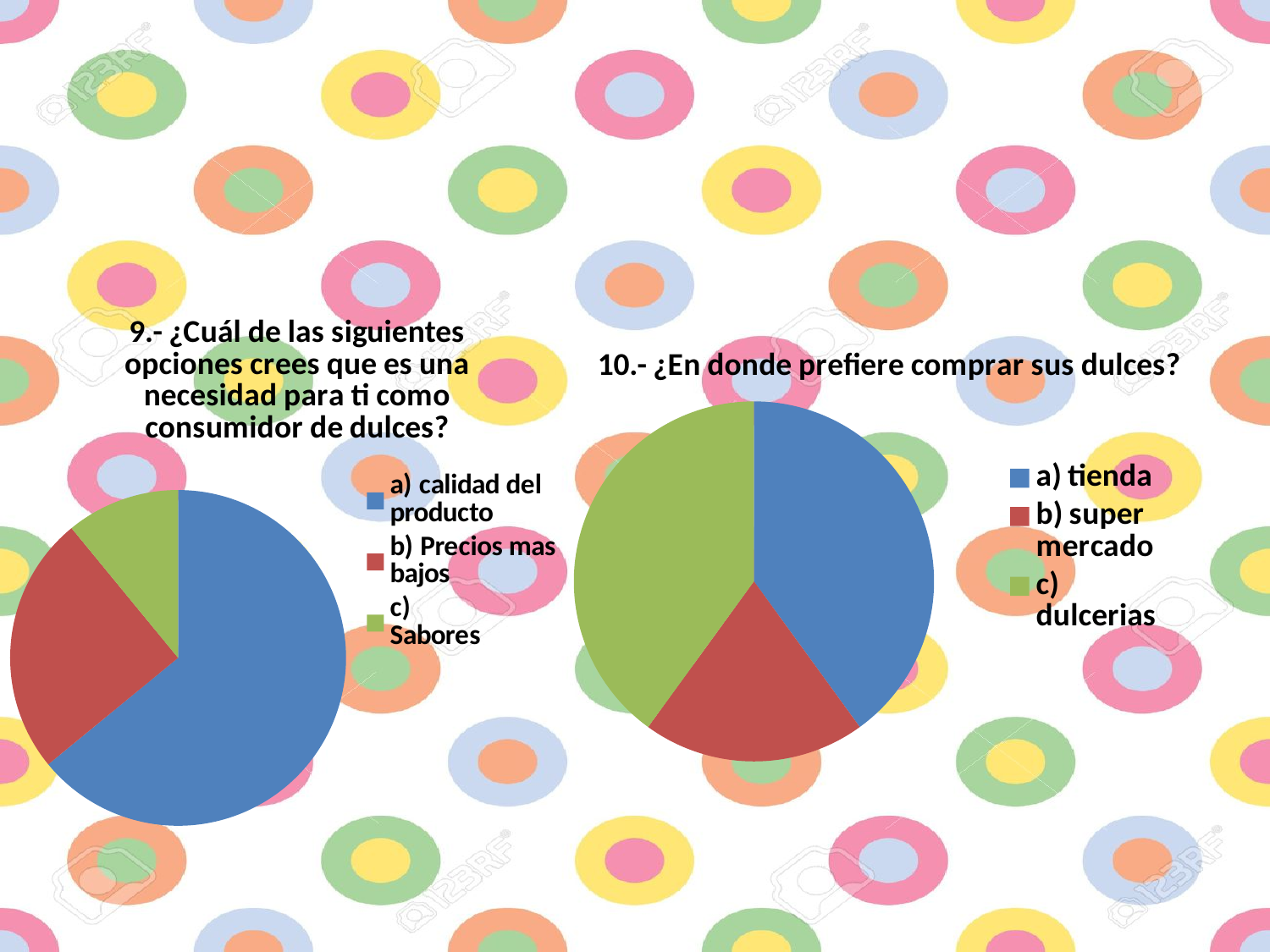
In the right chart (question 10), how many categories does the legend list? 3 What kind of chart is the right chart titled "10.- ¿En donde prefiere comprar sus dulces?"? pie chart In the left chart (question 9), which option has the smallest slice? c) Sabores In the left chart (question 9), which option has the largest slice? a) calidad del producto In the right chart (question 10), which slice is larger: c) dulcerias or b) super mercado? c) dulcerias In the right chart (question 10), which slice is larger: a) tienda or b) super mercado? a) tienda In the right chart (question 10), what colour is the slice for c) dulcerias? green What is the title of the right chart? 10.- ¿En donde prefiere comprar sus dulces? What kind of chart is the left chart titled "9.- ¿Cuál de las siguientes opciones crees que es una necesidad para ti como consumidor de dulces?"? pie chart In the left chart (question 9), how many slices does the pie have? 3 In the right chart (question 10), which option has the smallest slice? b) super mercado In the left chart (question 9), which slice is larger: a) calidad del producto or b) Precios mas bajos? a) calidad del producto